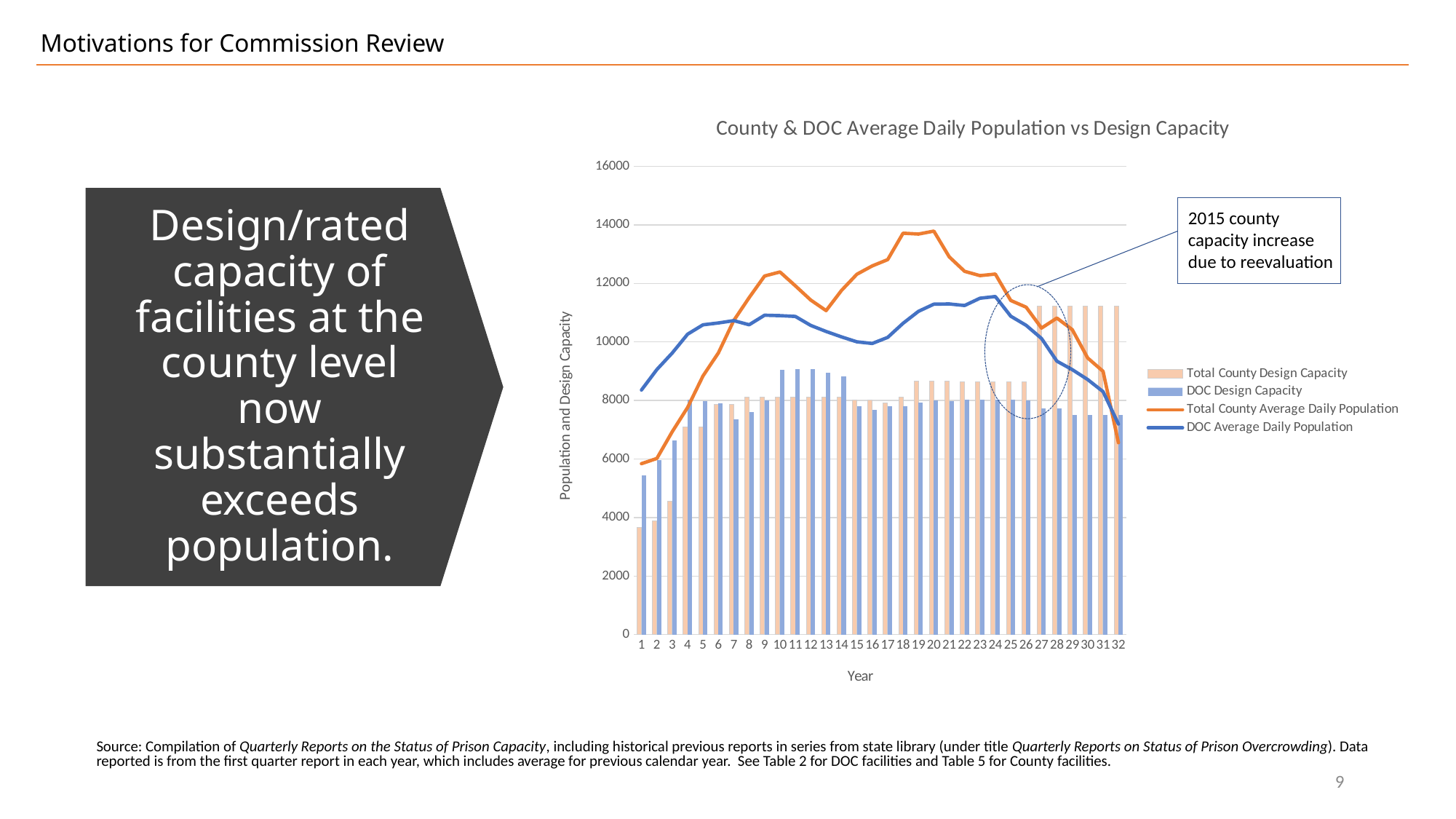
What kind of chart is shown on the slide? Combined bar and line chart At year 32, which is larger: Total County Design Capacity or DOC Design Capacity? Total County Design Capacity How many years are shown along the x axis of the chart? 32 At year 1, which is larger: Total County Average Daily Population or DOC Average Daily Population? DOC Average Daily Population Is the Total County Average Daily Population for year 18 greater or less than 12000? greater Is the DOC Average Daily Population for year 1 greater or less than 10000? less Is the DOC Design Capacity for year 32 greater or less than 8000? less How many series does the chart's legend list? 4 Does the DOC Average Daily Population line rise or fall from year 24 to year 32? fall What is the title of the chart on the slide? County & DOC Average Daily Population vs Design Capacity